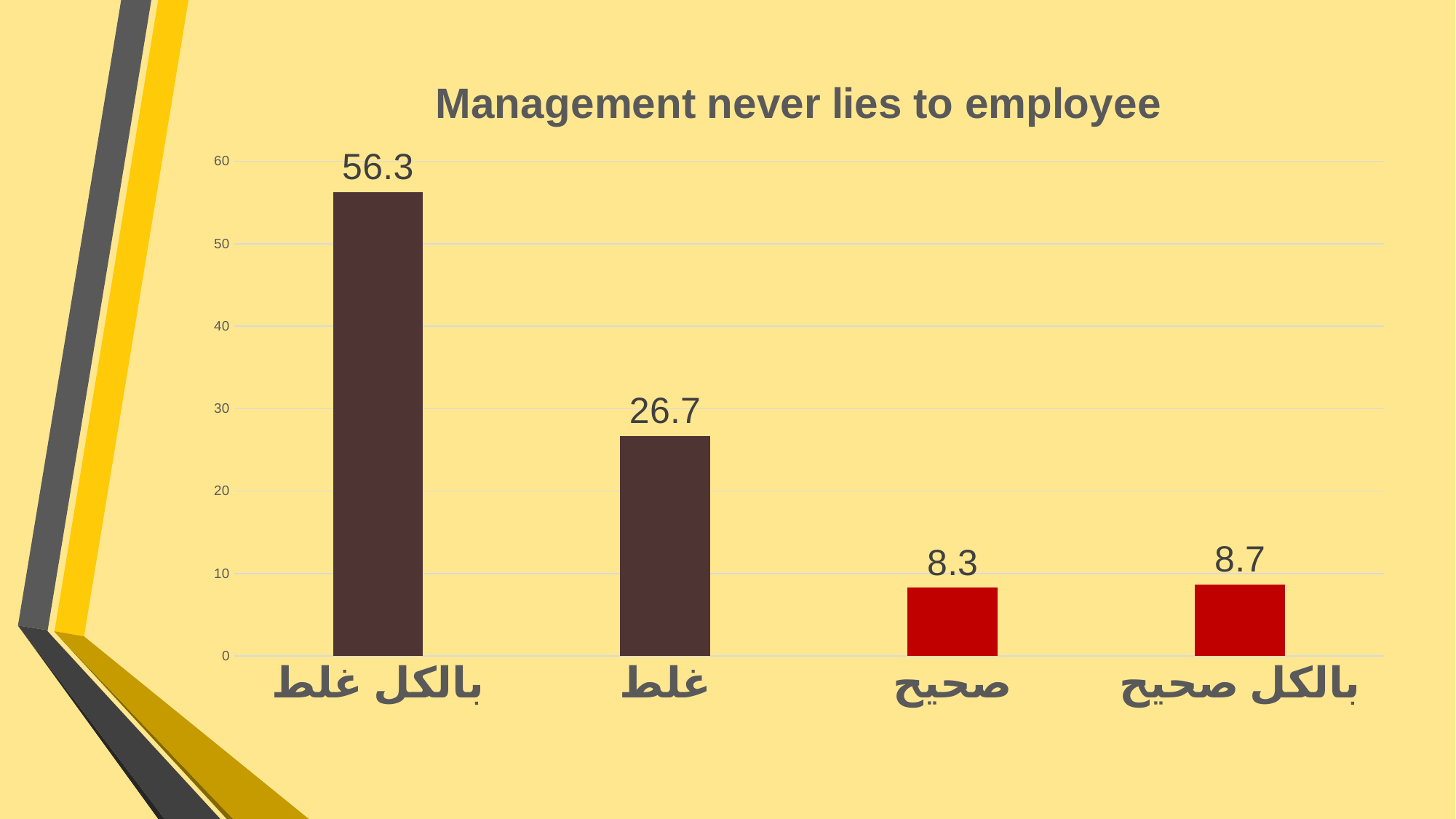
Is the value for غلط greater or less than 30? less Which category has the lowest value? صحيح Which category has the highest value? بالكل غلط What is the difference between the values for بالكل غلط and غلط? 29.6 What is the value for بالكل غلط? 56.3 What is the value for بالكل صحيح? 8.7 How many categories are shown on the x axis? 4 What kind of chart is shown on the slide? bar chart What is the value for غلط? 26.7 What is the title of the chart? Management never lies to employee What is the value for صحيح? 8.3 Which is larger, the value for غلط or the value for بالكل صحيح? غلط